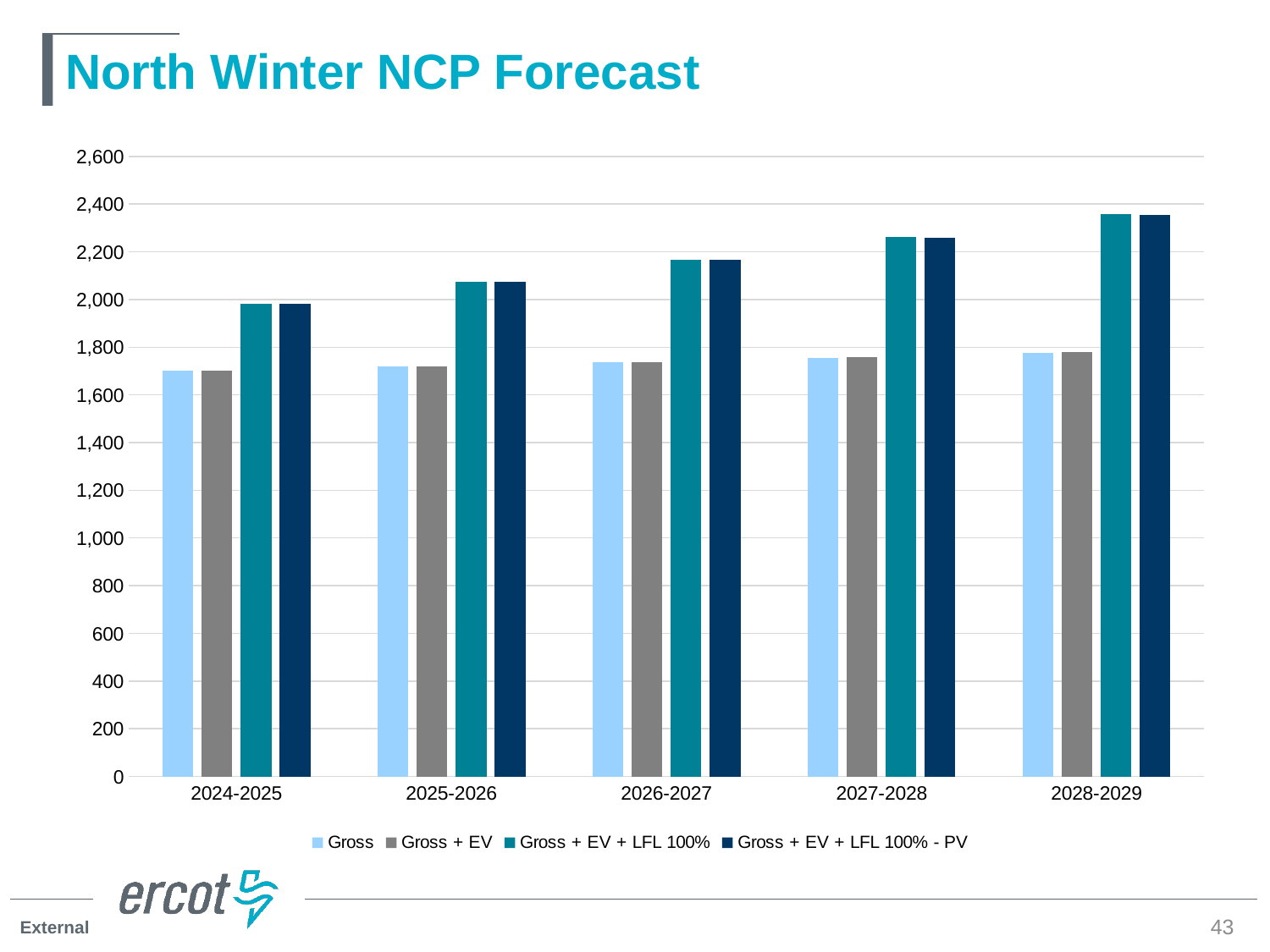
Which season has the lowest value for Gross? 2024-2025 Is the Gross value for 2024-2025 greater or less than 1,800? less How many winter seasons are shown on the x axis? 5 Is the Gross + EV + LFL 100% value for 2028-2029 greater or less than 2,200? greater How many series does the legend list? 4 Which series is listed last in the legend? Gross + EV + LFL 100% - PV Is the Gross + EV + LFL 100% value for 2026-2027 greater or less than 2,000? greater In 2026-2027, which is larger: Gross or Gross + EV + LFL 100%? Gross + EV + LFL 100% Which season has the highest value for Gross + EV + LFL 100%? 2028-2029 What kind of chart is shown on the slide? bar chart Do the Gross + EV + LFL 100% values rise or fall from 2024-2025 to 2028-2029? rise What is the title of the chart? North Winter NCP Forecast